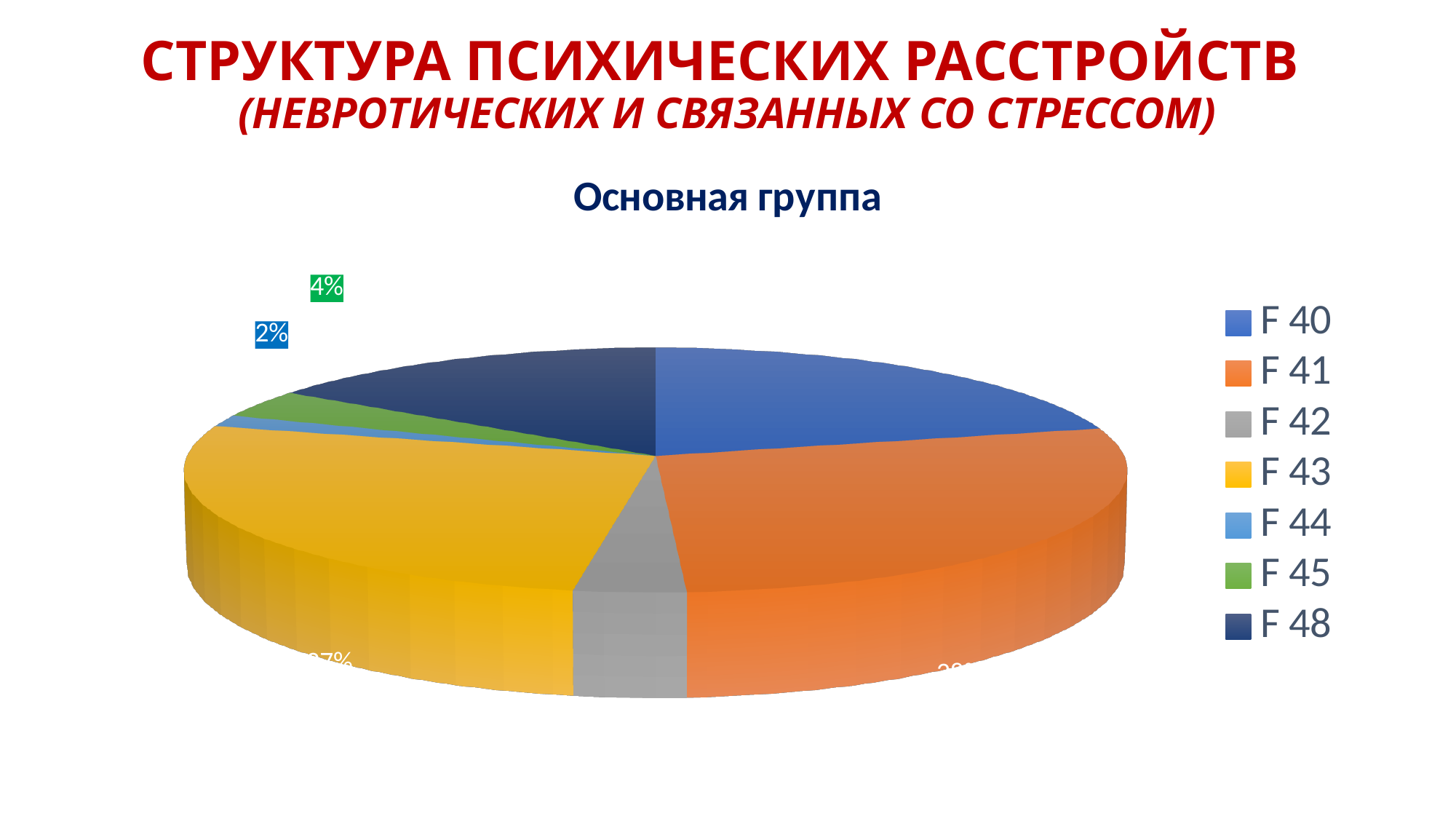
What is the title of the chart? Основная группа What percentage is shown for F 45 in the pie chart? 4% Which slice is larger, F 43 or F 44? F 43 Which slice is larger, F 41 or F 45? F 41 Which is larger in the pie chart, F 45 or F 44? F 45 How many categories does the legend of the pie chart list? 7 What is the difference between the shares of F 45 and F 44? 2% Which category has the smallest slice in the pie chart? F 44 What colour is the F 43 slice in the pie chart? yellow What kind of chart is shown on the slide? pie chart What percentage is shown for F 44 in the pie chart? 2%